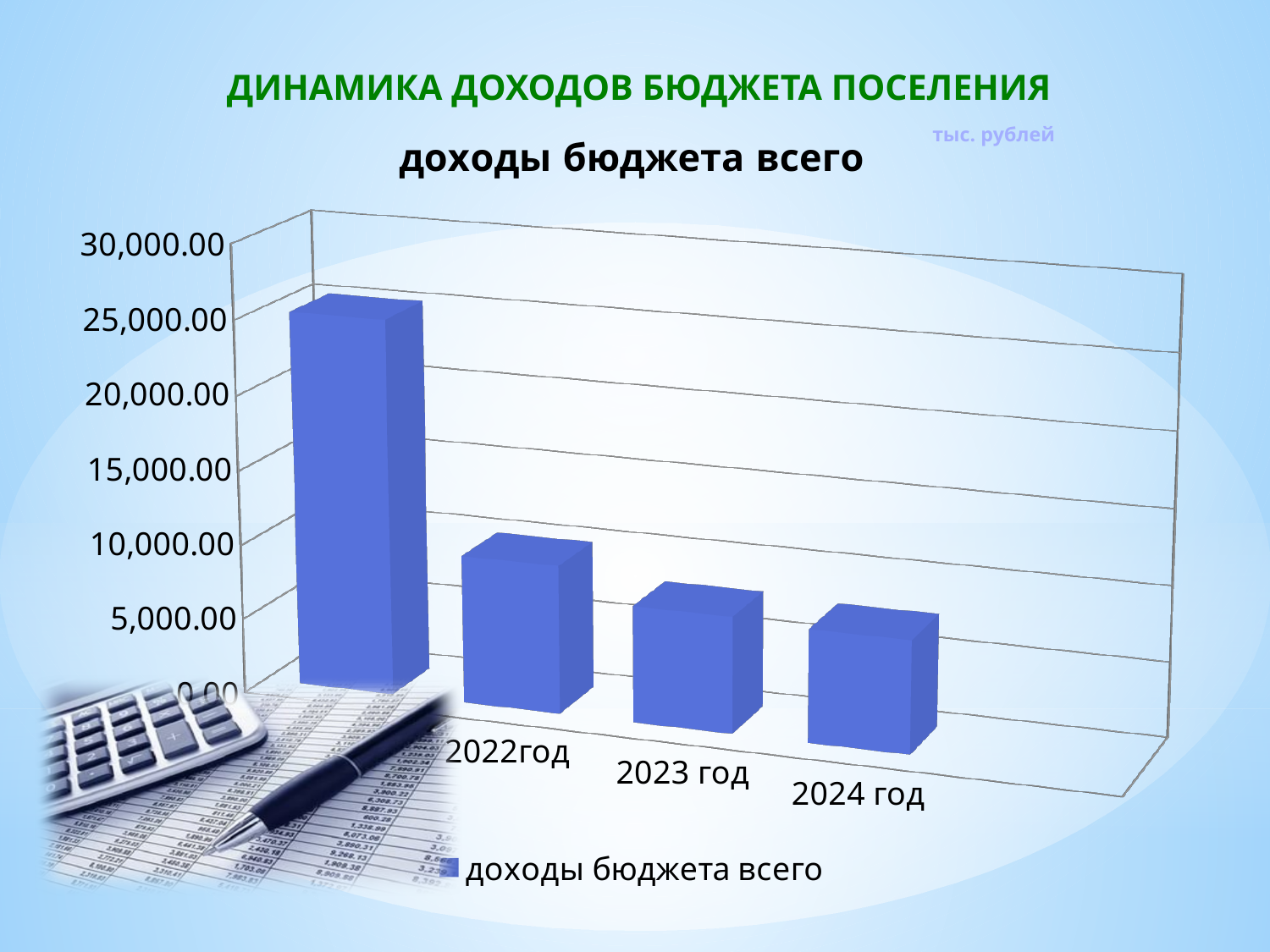
Is the value for 2023 год greater or less than 10,000.00? less What kind of chart is shown on the slide? bar chart What is the title of the chart? доходы бюджета всего Which is larger, the value for 2023 год or the value for 2024 год? 2023 год Do the values rise or fall from left to right along the x axis? fall How many series does the legend list? 1 Is the value for 2022год greater or less than 5,000.00? greater Which of the labelled years has the lowest value? 2024 год How many bars are plotted in the chart? 4 Which is larger, the value for 2022год or the value for 2024 год? 2022год What unit is indicated for the chart values? тыс. рублей Is the value for 2024 год greater or less than 10,000.00? less